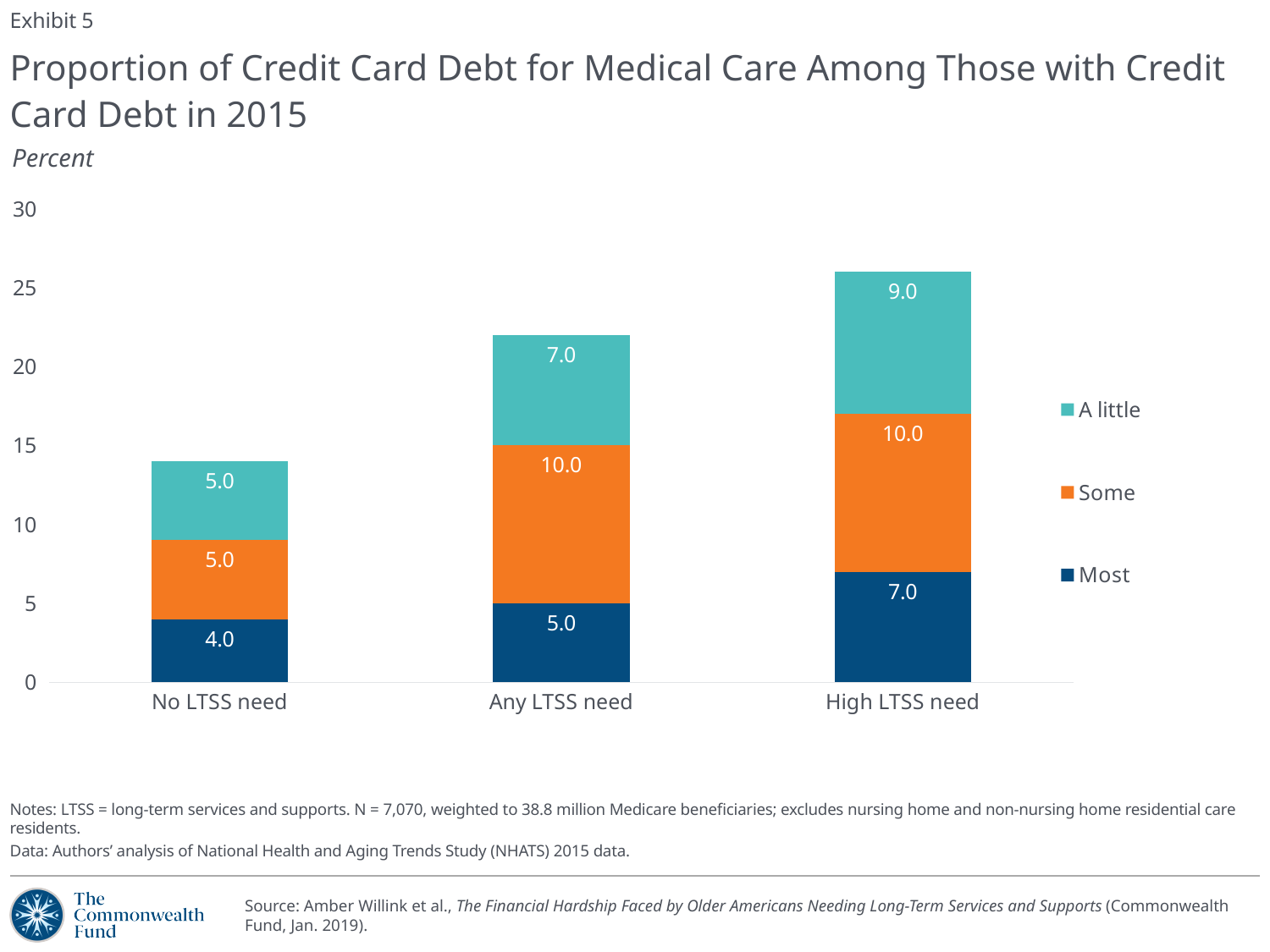
Which category has the highest value for "Most"? High LTSS need Which category has the lowest value for "A little"? No LTSS need What is the total of the stacked bar for Any LTSS need? 22.0 How many categories are shown on the x axis? 3 What is the value for "Most" in the No LTSS need category? 4.0 How many series does the legend list? 3 Which is larger: the "A little" value for Any LTSS need or for High LTSS need? High LTSS need What is the difference between the "Some" values for High LTSS need and No LTSS need? 5.0 What kind of chart is shown on the slide? Stacked bar chart What is the total of the stacked bar for High LTSS need? 26.0 What is the value for "A little" in the High LTSS need category? 9.0 What is the value for "Some" in the Any LTSS need category? 10.0